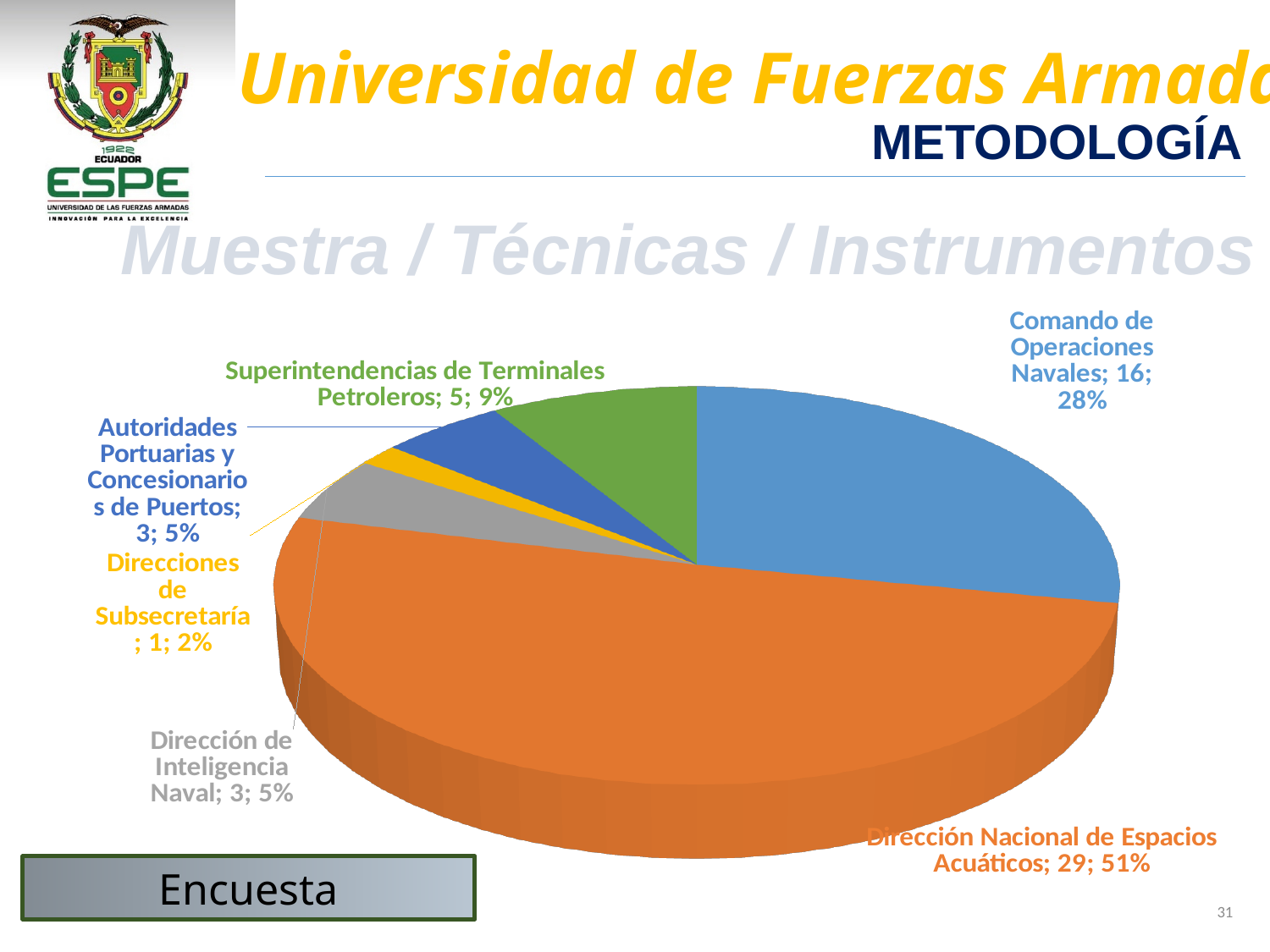
Which category has the largest slice of the pie? Dirección Nacional de Espacios Acuáticos Which is larger, the value for Superintendencias de Terminales Petroleros or the value for Autoridades Portuarias y Concesionarios de Puertos? Superintendencias de Terminales Petroleros What is the value for Direcciones de Subsecretaría? 1 What is the value for Superintendencias de Terminales Petroleros? 5 How many slices does the pie chart have? 6 What share of the pie does Dirección de Inteligencia Naval represent? 5% What is the difference between the values for Dirección Nacional de Espacios Acuáticos and Comando de Operaciones Navales? 13 What share of the pie does Comando de Operaciones Navales represent? 28% Which category has the smallest slice of the pie? Direcciones de Subsecretaría What kind of chart is shown on the slide? Pie chart What is the value for Comando de Operaciones Navales? 16 What is the value for Dirección Nacional de Espacios Acuáticos? 29